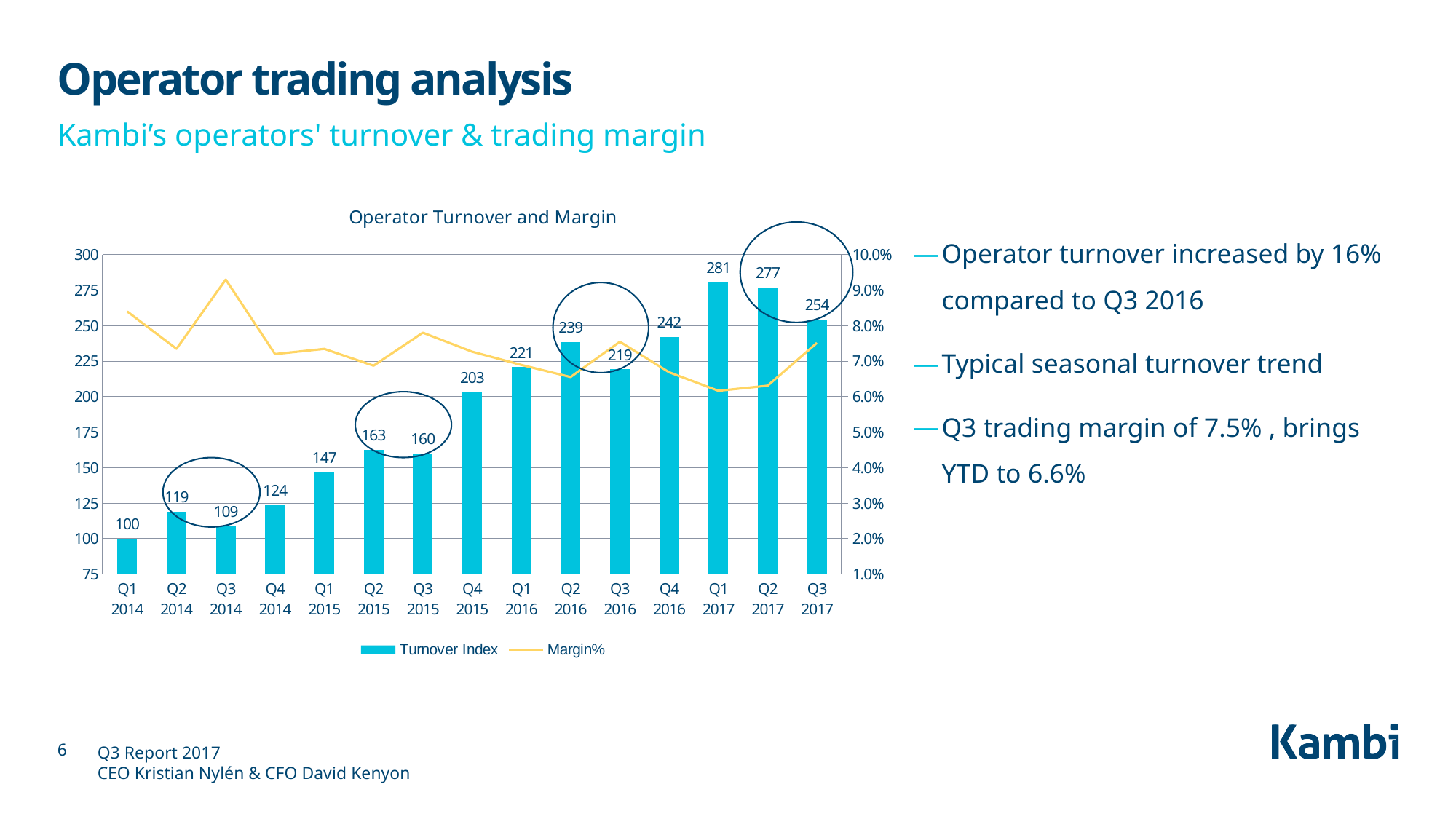
What is the Turnover Index value for Q3 2017? 254 Which has a higher Turnover Index, Q2 2016 or Q4 2016? Q4 2016 What kind of chart is used to show the Turnover Index? Bar chart Which quarter has the highest Turnover Index? Q1 2017 What is the Turnover Index value for Q4 2015? 203 Is the Margin% value for Q3 2014 greater or less than 8.0%? greater What is the title of the chart? Operator Turnover and Margin How many quarters are shown on the x axis? 15 What is the difference in Turnover Index between Q3 2017 and Q3 2016? 35 What is the Turnover Index value for Q1 2014? 100 How many series does the legend list? 2 Which quarter has the lowest Turnover Index? Q1 2014